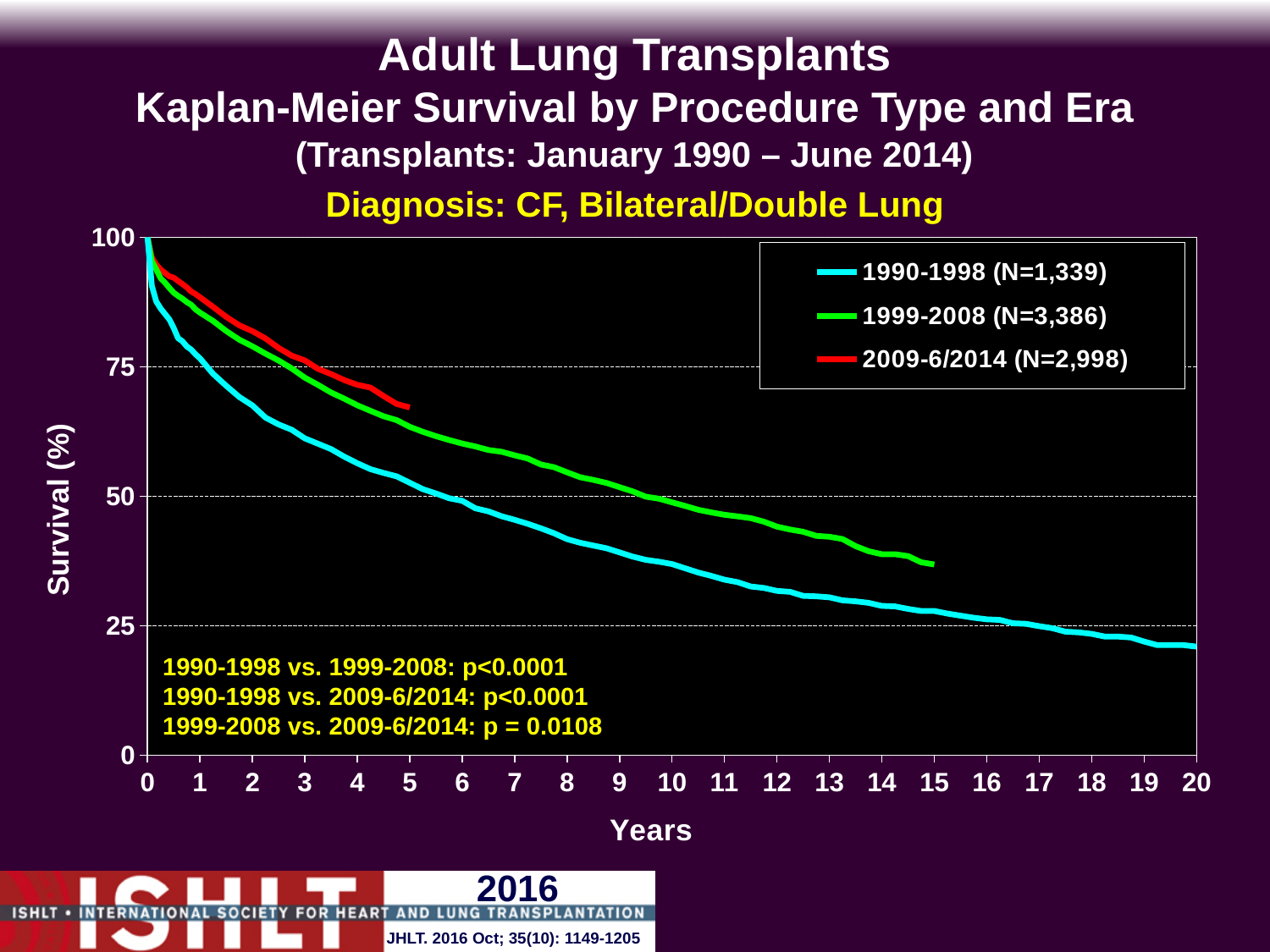
Is the survival value for the 1999-2008 series at 5 years greater or less than 50? greater What kind of chart is shown on the slide? line chart What is the N for the 1999-2008 series shown in the legend? N=3,386 Do the survival curves rise or fall as the years increase? fall What is the N for the 2009-6/2014 series shown in the legend? N=2,998 What is the N for the 1990-1998 series shown in the legend? N=1,339 How many series does the legend list? 3 At 5 years, which series has the higher survival: 1990-1998 or 1999-2008? 1999-2008 Is the survival value for the 1990-1998 series at 10 years greater or less than 50? less Which series has the lowest survival at 5 years? 1990-1998 Is the survival value for the 2009-6/2014 series at 2 years greater or less than 75? greater What p-value is shown for 1999-2008 vs. 2009-6/2014? p = 0.0108